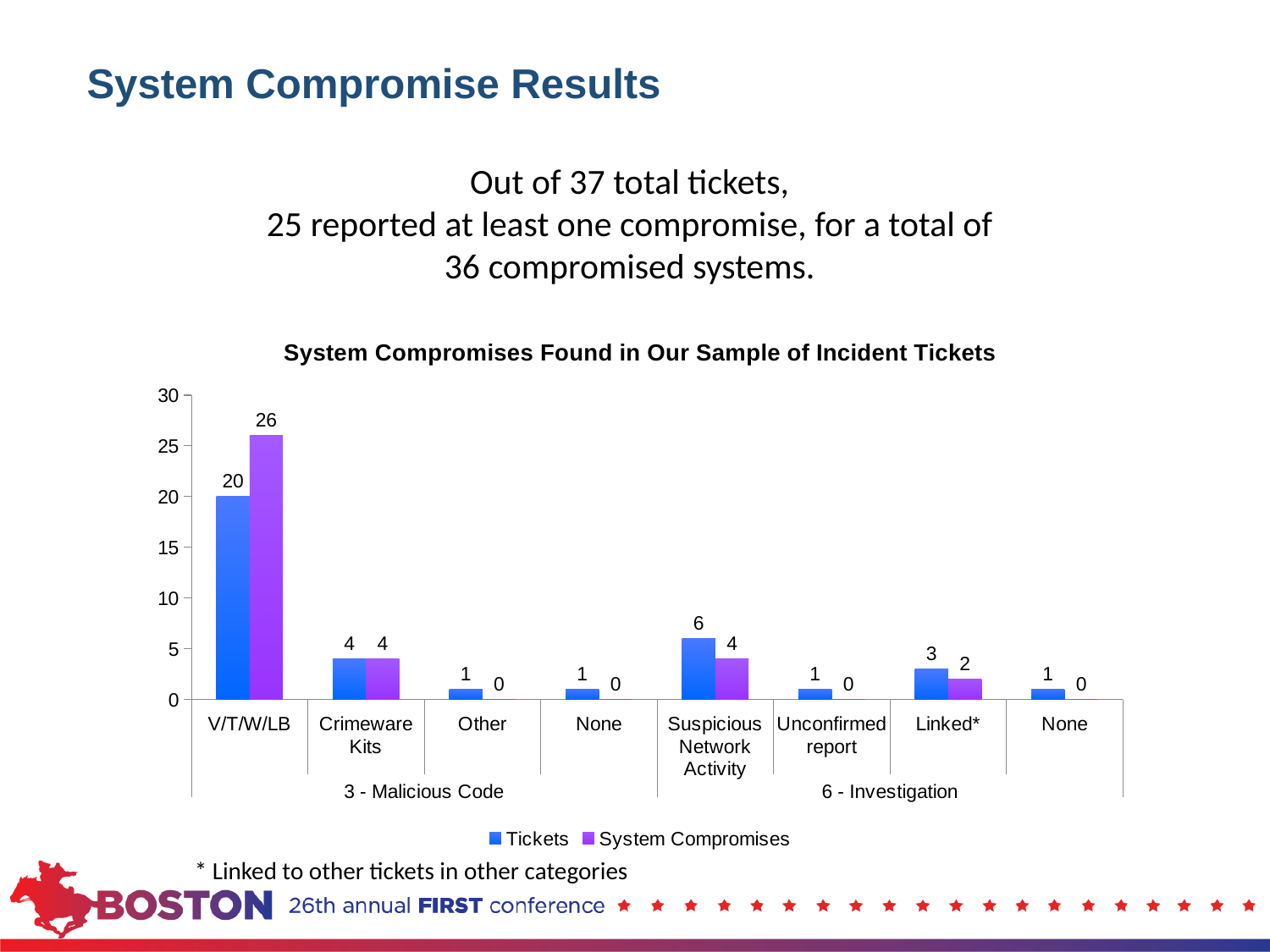
What is the difference between System Compromises and Tickets for V/T/W/LB? 6 What is the title of the chart? System Compromises Found in Our Sample of Incident Tickets What is the number of System Compromises for V/T/W/LB? 26 What kind of chart is shown on the slide? Bar chart What is the number of Tickets for V/T/W/LB? 20 What is the System Compromises value for Unconfirmed report? 0 Which category has the highest number of System Compromises? V/T/W/LB How many categories are shown on the x axis? 8 How many Tickets are shown for Suspicious Network Activity? 6 What is the System Compromises value for Linked*? 2 For Suspicious Network Activity, which is larger: Tickets or System Compromises? Tickets How many series does the legend list? 2